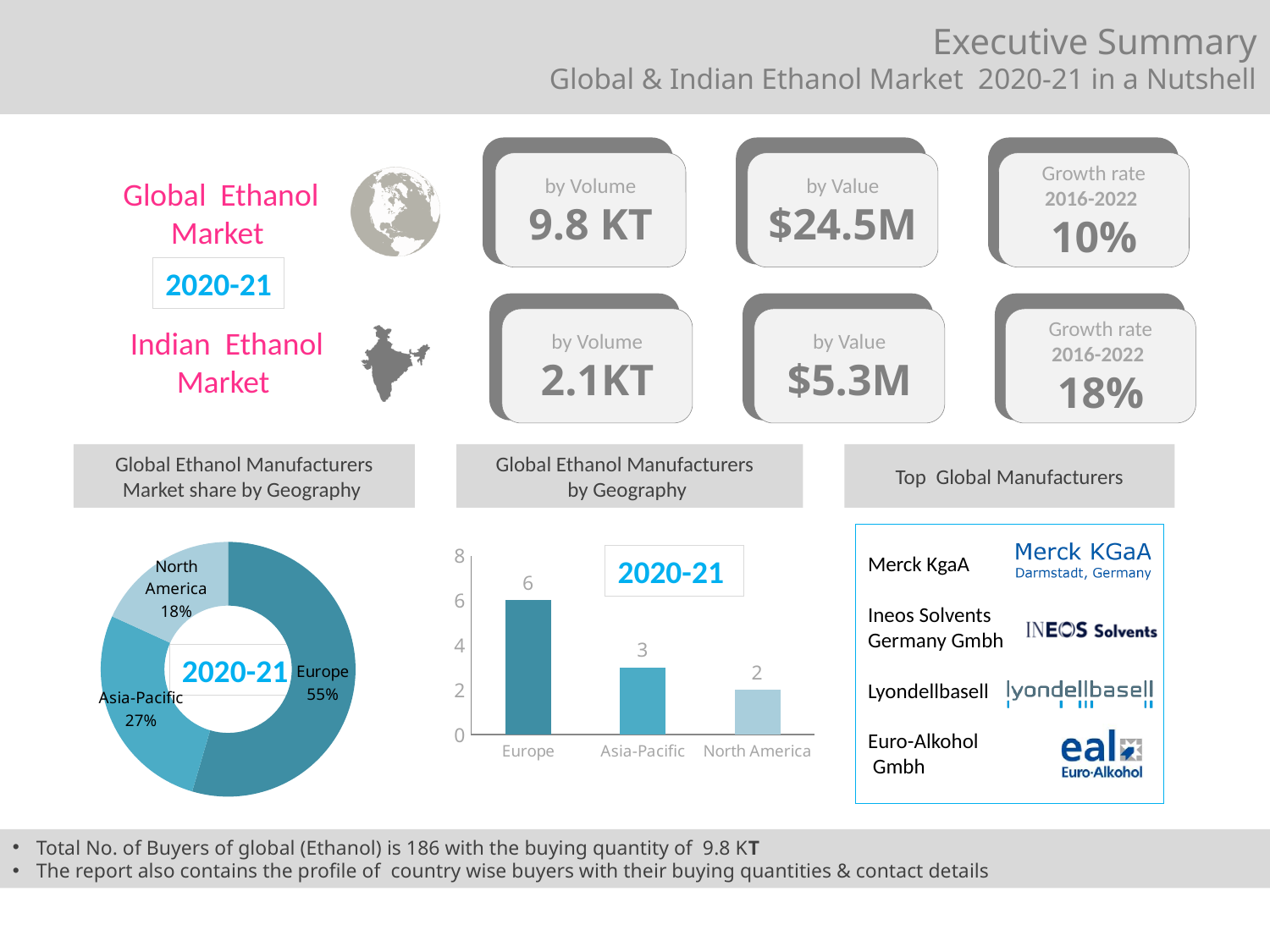
In the 'Global Ethanol Manufacturers Market share by Geography' pie chart, how many slices are there? 3 In the 'Global Ethanol Manufacturers by Geography' chart, what is the value for Europe? 6 In the 'Global Ethanol Manufacturers by Geography' chart, what is the difference between the values for Europe and Asia-Pacific? 3 In the 'Global Ethanol Manufacturers by Geography' chart, which is larger, Asia-Pacific or North America? Asia-Pacific In the 'Global Ethanol Manufacturers Market share by Geography' pie chart, what share does Asia-Pacific have? 27% In the 'Global Ethanol Manufacturers by Geography' chart, what is the value for North America? 2 In the 'Global Ethanol Manufacturers Market share by Geography' pie chart, what share does Europe have? 55% What kind of chart is the 'Global Ethanol Manufacturers by Geography' chart? Bar chart In the 'Global Ethanol Manufacturers by Geography' chart, is the value for Europe greater or less than 4? greater In the 'Global Ethanol Manufacturers Market share by Geography' pie chart, which region has the largest share? Europe In the 'Global Ethanol Manufacturers by Geography' chart, do the values rise or fall from Europe to North America? Fall In the 'Global Ethanol Manufacturers Market share by Geography' pie chart, which region has the smallest share? North America